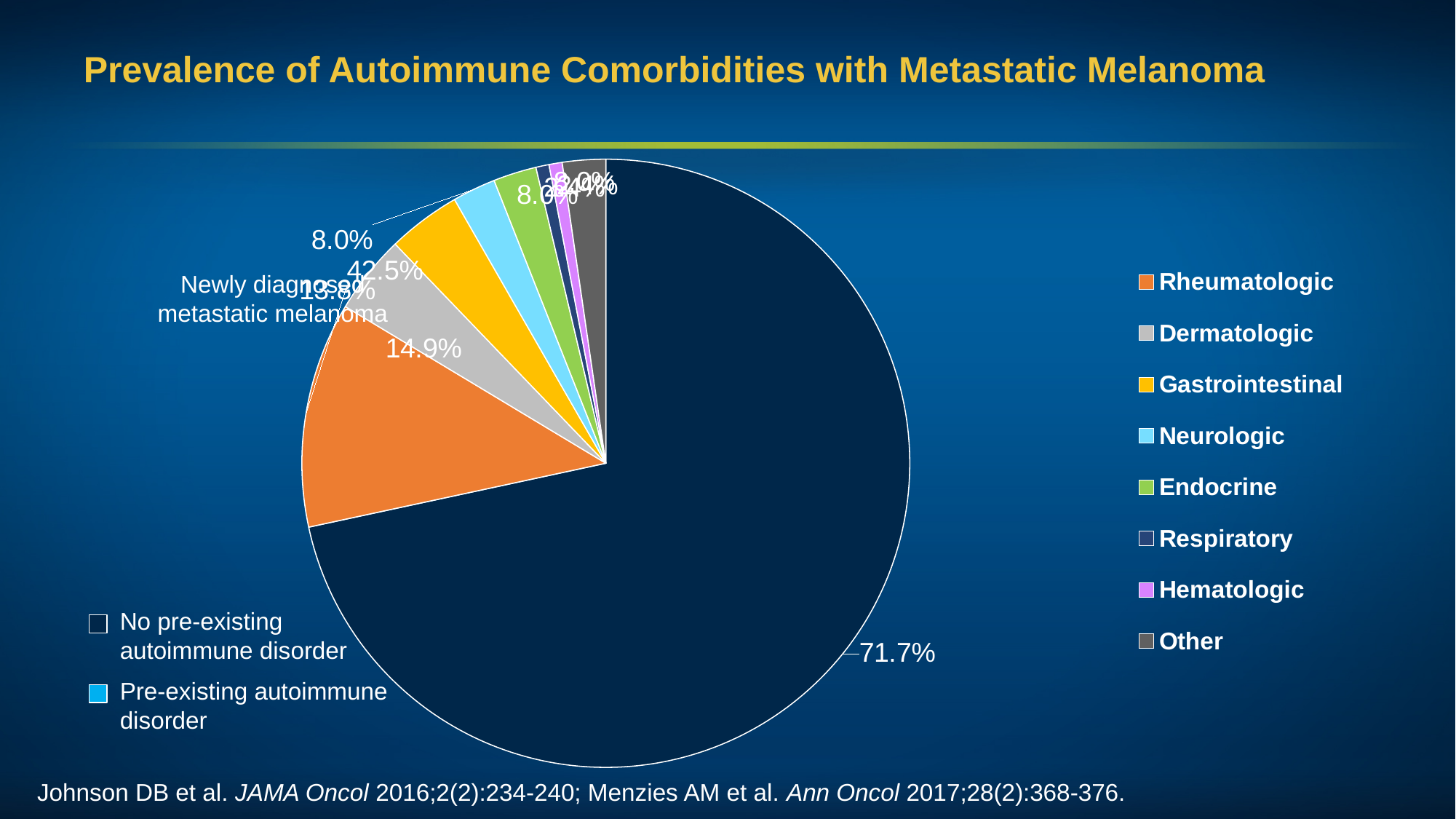
What is the title of the chart? Prevalence of Autoimmune Comorbidities with Metastatic Melanoma Which slice of the pie is the largest? No pre-existing autoimmune disorder Is the Dermatologic slice greater or less than 25% of the pie? less What colour is the Rheumatologic slice? Orange How many autoimmune disorder categories are listed in the legend on the right? 8 Which slice is larger, Gastrointestinal or Neurologic? Gastrointestinal Which slice is larger, Rheumatologic or Dermatologic? Rheumatologic What kind of chart is shown on the slide? Pie chart What percentage of patients had no pre-existing autoimmune disorder? 71.7%